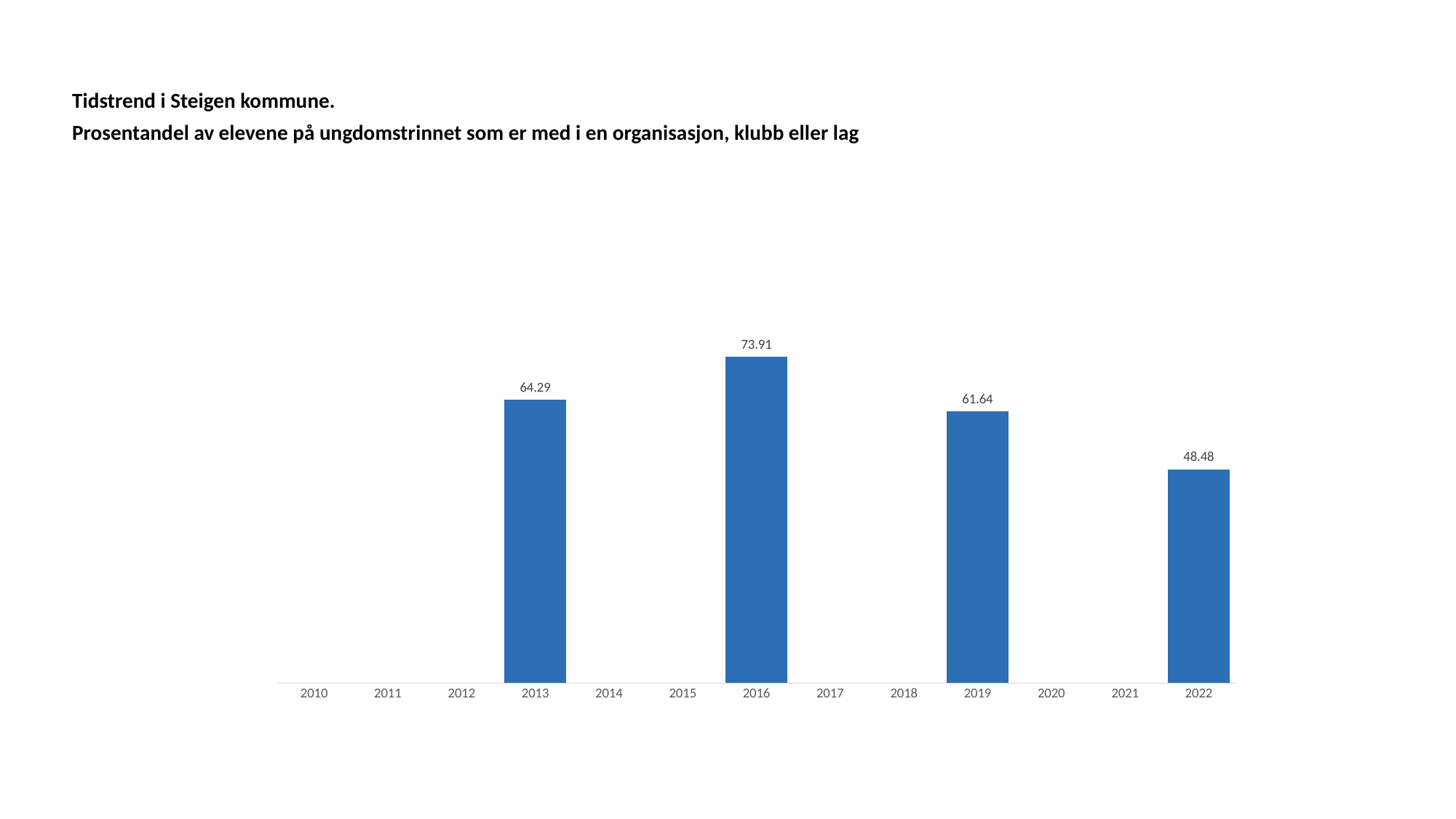
What is the difference between the values for 2013 and 2019? 2.65 Which is larger, the value for 2013 or the value for 2019? 2013 What is the value for 2019? 61.64 What is the value for 2016? 73.91 How many years have a bar plotted? 4 What is the value for 2013? 64.29 What kind of chart is shown? Bar chart Do the values rise or fall from 2016 to 2022? Fall What is the value for 2022? 48.48 Which year has the highest value? 2016 Which year with a bar has the lowest value? 2022 What is the difference between the values for 2016 and 2022? 25.43